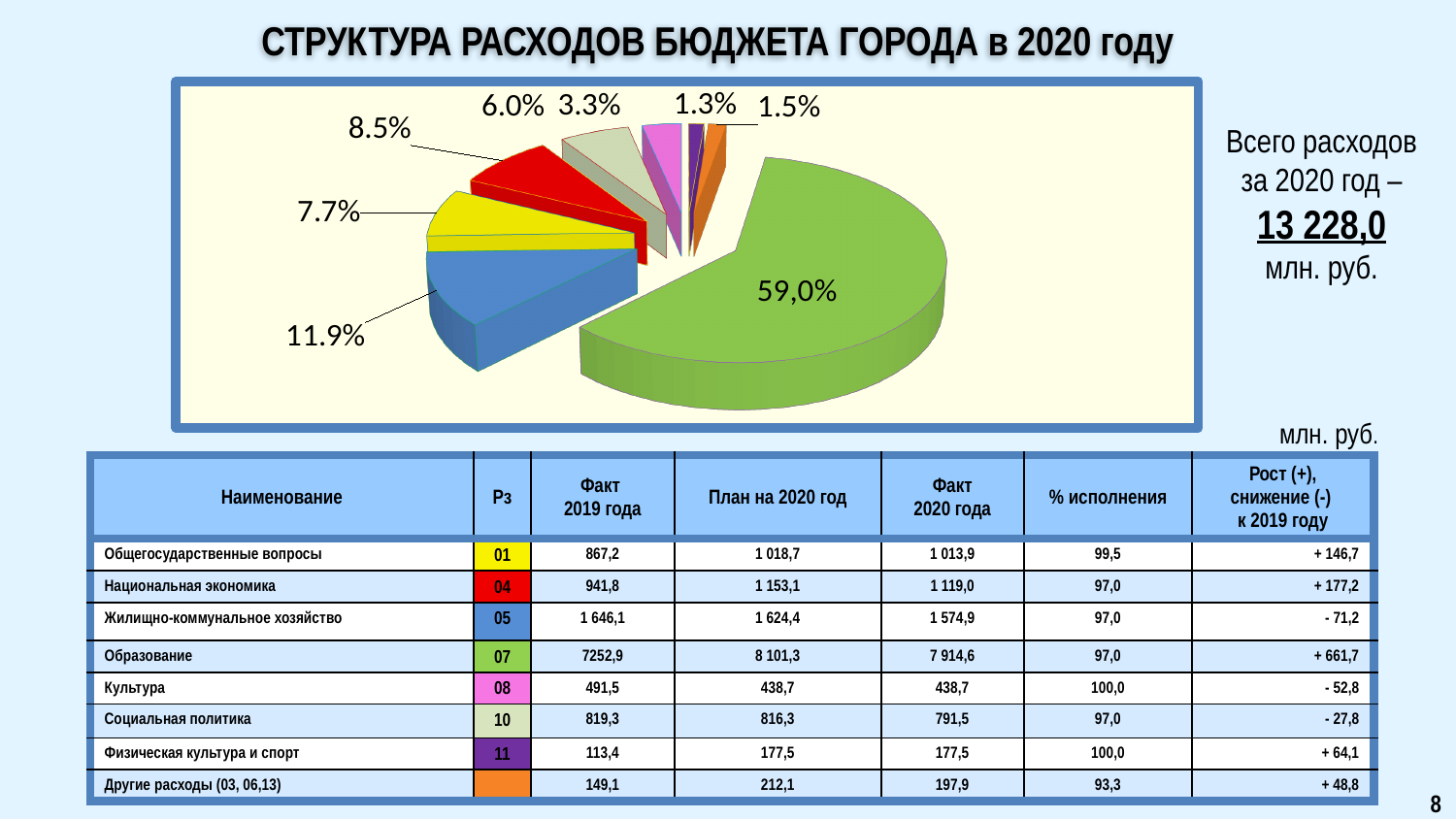
What share is labelled on the blue slice of the pie chart? 11.9% What kind of chart is shown on the slide? pie chart By how many percentage points does the 59,0% slice exceed the 11,9% slice? 47,1 What is the difference between the 6,0% slice and the 3,3% slice? 2,7 percentage points Which slice is larger, the red slice (8,5%) or the yellow slice (7,7%)? the red slice (8,5%) What is the share of the largest slice in the pie chart? 59,0% What is the share of the smallest slice in the pie chart? 1.3% What total expenditure for 2020 is stated next to the pie chart? 13 228,0 млн. руб. Which is larger, the 1,5% slice or the 1,3% slice? the 1,5% slice What share is labelled on the red slice of the pie chart? 8.5% How many slices does the pie chart have? 8 What share is labelled on the yellow slice of the pie chart? 7.7%